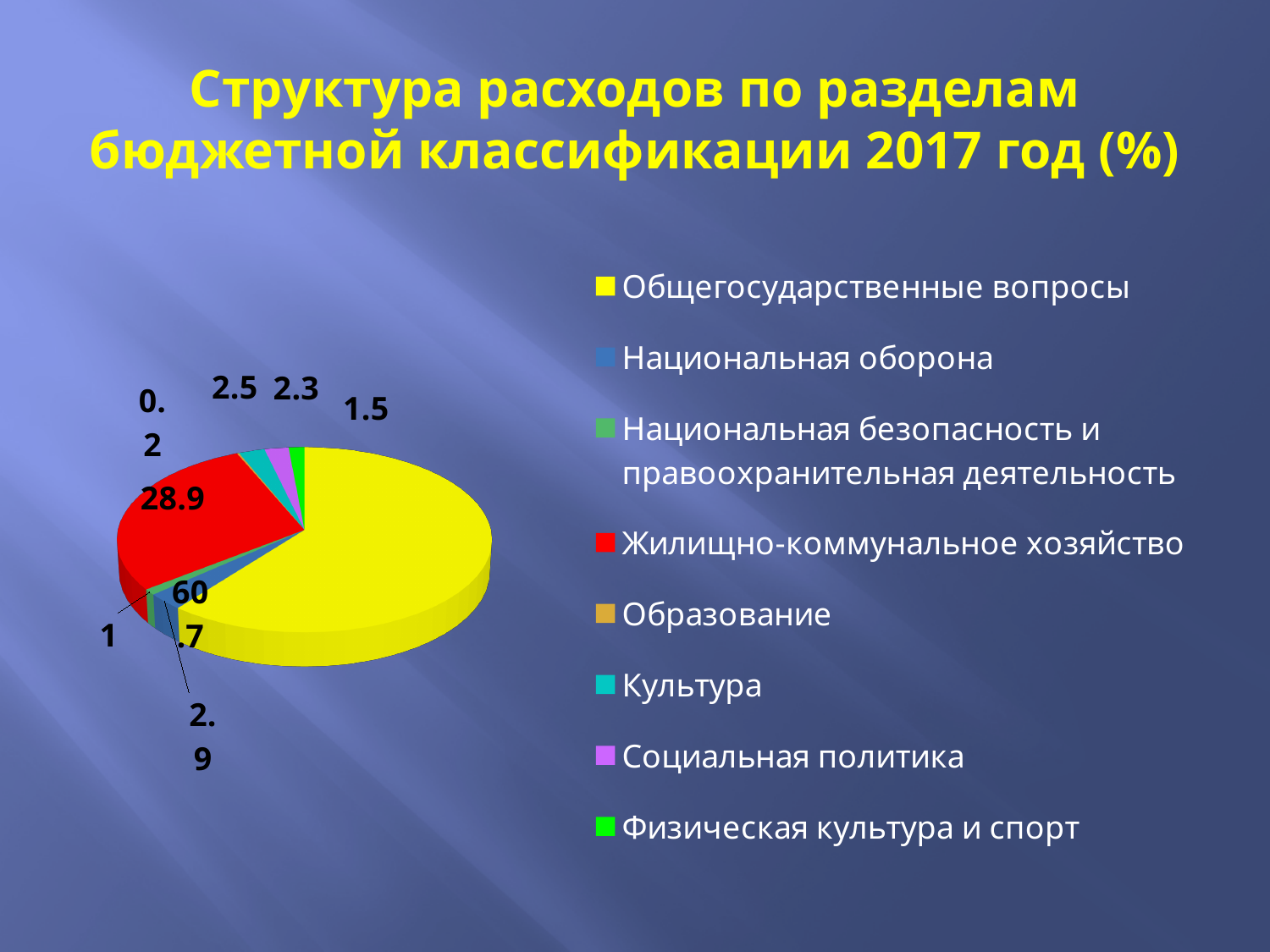
What is the difference between the values for Жилищно-коммунальное хозяйство and Культура? 26.4 What is the value for Культура? 2.5 What is the value for Социальная политика? 2.3 What is the value for Общегосударственные вопросы? 60.7 What type of chart is shown on the slide? Pie chart Which category has the smallest share of the pie? Образование What is the value for Физическая культура и спорт? 1.5 Which is larger, the value for Культура or the value for Социальная политика? Культура What colour is the slice for Жилищно-коммунальное хозяйство? Red What is the value for Жилищно-коммунальное хозяйство? 28.9 How many categories does the pie chart have? 8 Which category has the largest share of the pie? Общегосударственные вопросы